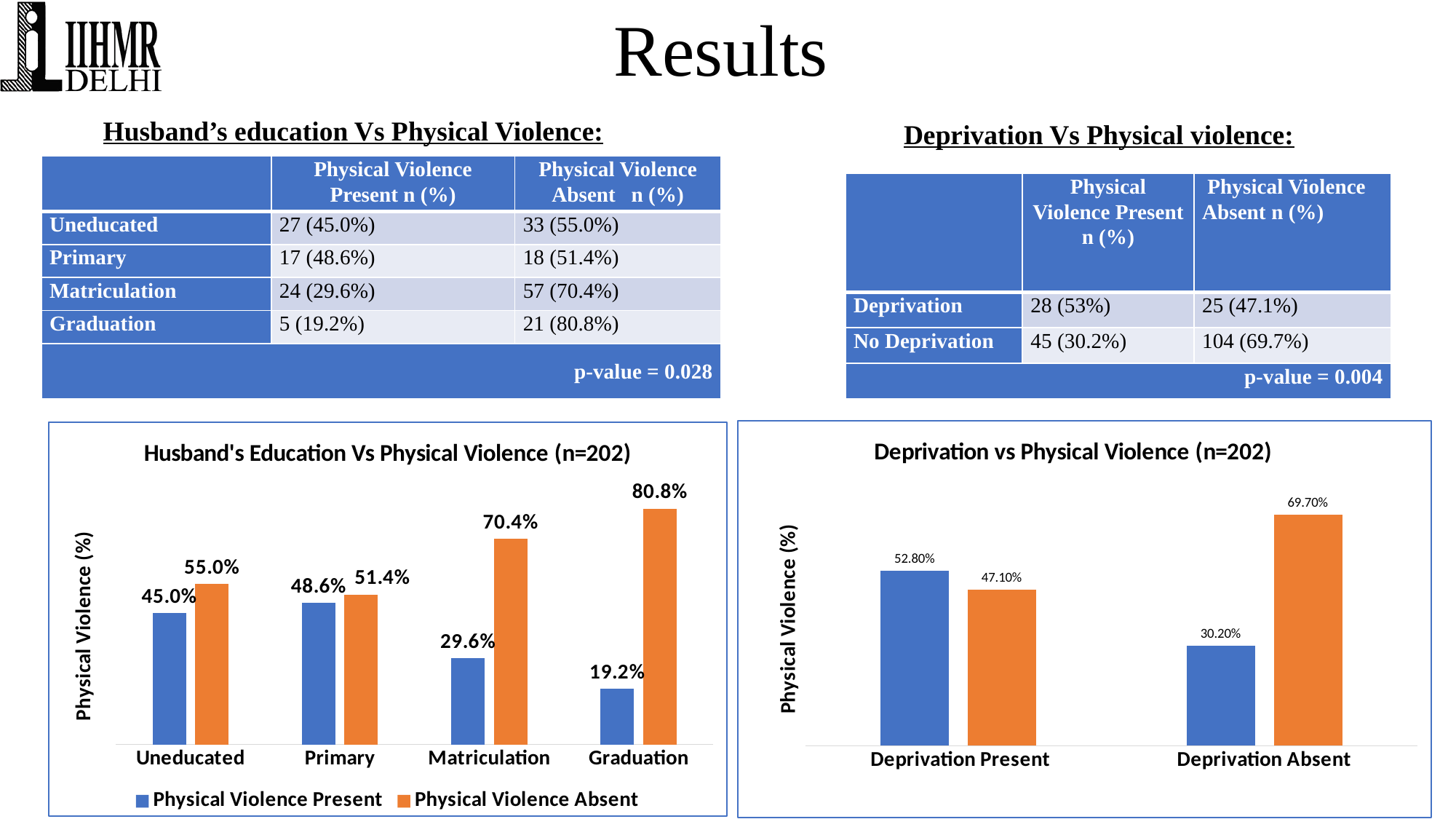
In the 'Husband's Education Vs Physical Violence (n=202)' chart, which category has the highest Physical Violence Absent value? Graduation In the 'Husband's Education Vs Physical Violence (n=202)' chart, does the Physical Violence Present value rise or fall from Primary to Graduation? fall In the 'Husband's Education Vs Physical Violence (n=202)' chart, how many education categories are shown on the x axis? 4 In the 'Husband's Education Vs Physical Violence (n=202)' chart, which category has the lowest Physical Violence Present value? Graduation In the 'Husband's Education Vs Physical Violence (n=202)' chart, how many series does the legend list? 2 In the 'Deprivation vs Physical Violence (n=202)' chart, what is the value of the orange bar for Deprivation Absent? 69.70% In the 'Husband's Education Vs Physical Violence (n=202)' chart, what is the Physical Violence Present value for Graduation? 19.2% What type of chart is the 'Deprivation vs Physical Violence (n=202)' chart? bar chart In the 'Husband's Education Vs Physical Violence (n=202)' chart, what is the Physical Violence Absent value for Matriculation? 70.4% In the 'Deprivation vs Physical Violence (n=202)' chart, what is the value of the blue bar for Deprivation Present? 52.80% In the 'Husband's Education Vs Physical Violence (n=202)' chart, what is the difference between the Physical Violence Absent and Physical Violence Present values for Uneducated? 10.0% In the 'Deprivation vs Physical Violence (n=202)' chart, which is larger for Deprivation Present: the blue bar or the orange bar? the blue bar